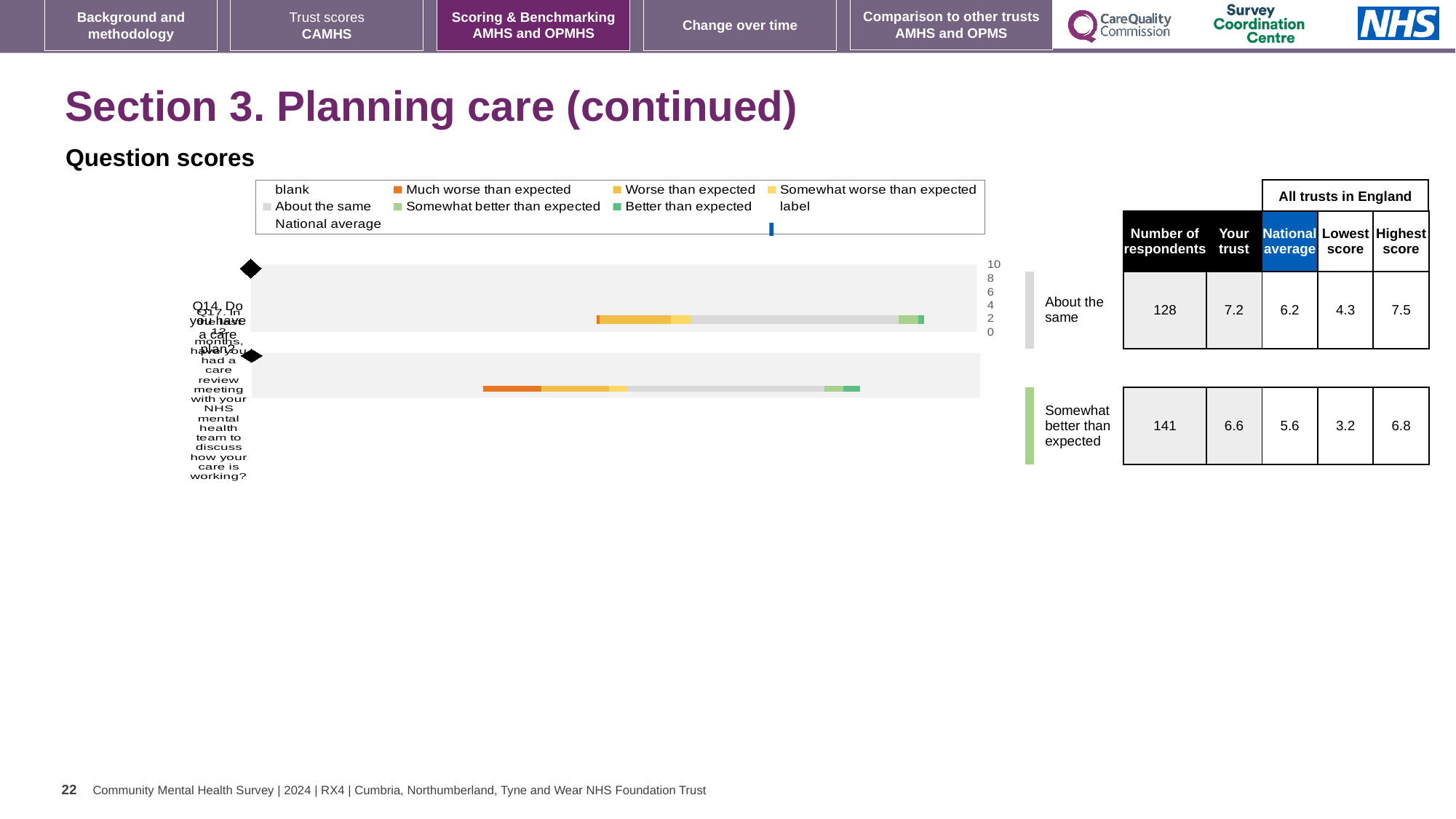
What is the lowest score across all trusts in England for the top bar (Q14)? 4.3 Which question has the higher 'Your trust' score, Q14 or Q17? Q14 What is the difference between the highest and lowest scores for Q17? 3.6 How many question bars are plotted in the chart? 2 What is the 'Your trust' score for the top bar (Q14, care plan)? 7.2 Which benchmark category is shown next to the top bar (Q14)? About the same Which benchmark category is shown next to the bottom bar (Q17)? Somewhat better than expected How many respondents are listed for the top bar (Q14)? 128 What is the highest score across all trusts in England for the bottom bar (Q17)? 6.8 By how much does the trust's score for Q14 exceed the national average? 1.0 What kind of chart is shown under 'Question scores'? bar chart What is the national average for the bottom bar (Q17, care review meeting)? 5.6